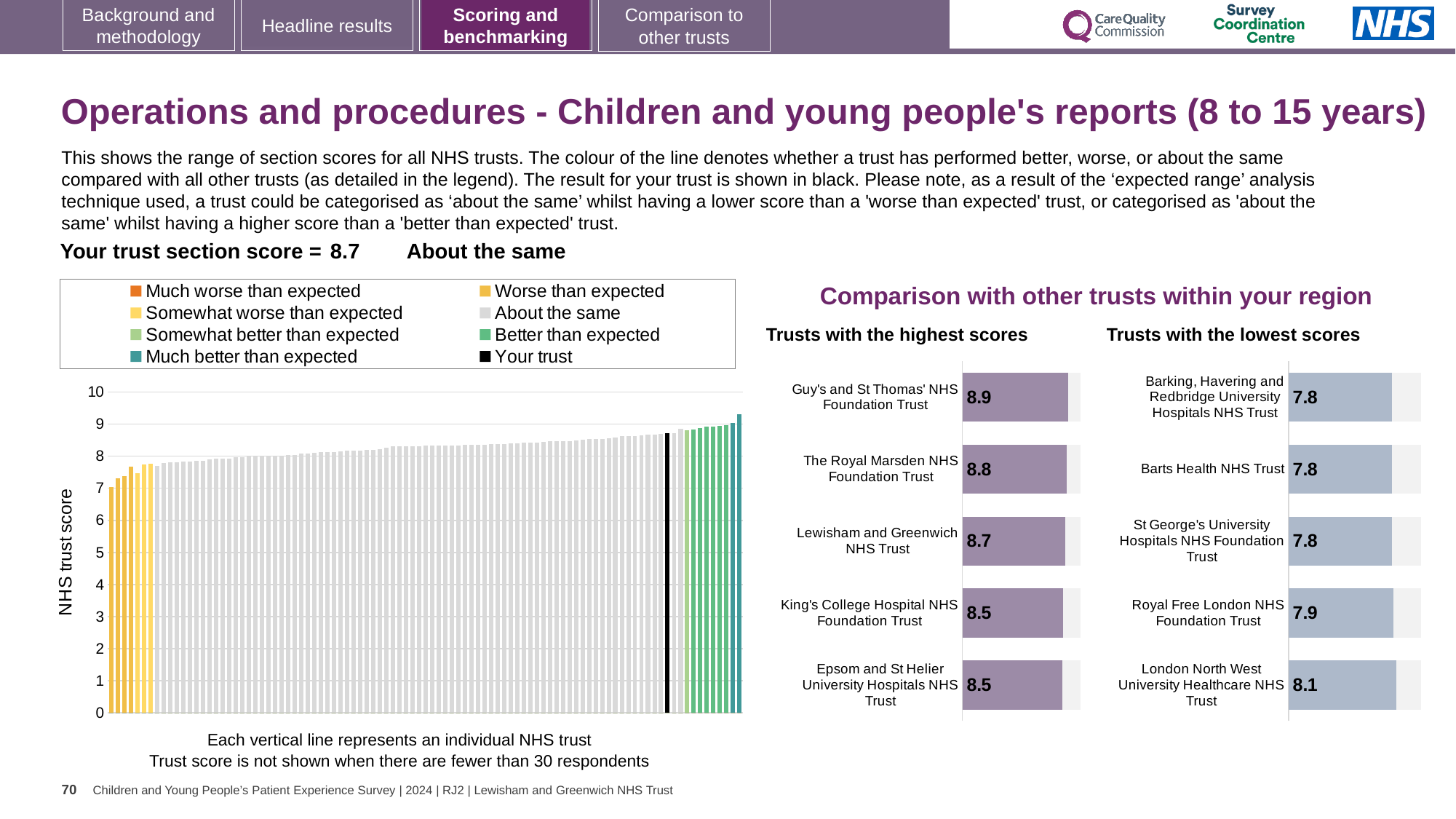
In the 'Trusts with the highest scores' chart, what is the difference between the scores of Guy's and St Thomas' NHS Foundation Trust and King's College Hospital NHS Foundation Trust? 0.4 In the main chart on the left, do the trust scores rise or fall from left to right? Rise In the main chart on the left, how many entries does the legend list? 8 In the 'Trusts with the highest scores' chart, how many trusts are shown? 5 In the 'Trusts with the lowest scores' chart, which trust has the highest score? London North West University Healthcare NHS Trust In the 'Trusts with the highest scores' chart, what is the score for Lewisham and Greenwich NHS Trust? 8.7 In the 'Trusts with the lowest scores' chart, what is the score for London North West University Healthcare NHS Trust? 8.1 In the 'Trusts with the highest scores' chart, which trust has the highest score? Guy's and St Thomas' NHS Foundation Trust In the main chart on the left showing the range of section scores, what kind of chart is it? Bar chart In the 'Trusts with the lowest scores' chart, what is the difference between the scores of London North West University Healthcare NHS Trust and Barts Health NHS Trust? 0.3 In the 'Trusts with the highest scores' chart, what is the score for Guy's and St Thomas' NHS Foundation Trust? 8.9 In the 'Trusts with the lowest scores' chart, which has the larger score: Royal Free London NHS Foundation Trust or London North West University Healthcare NHS Trust? London North West University Healthcare NHS Trust